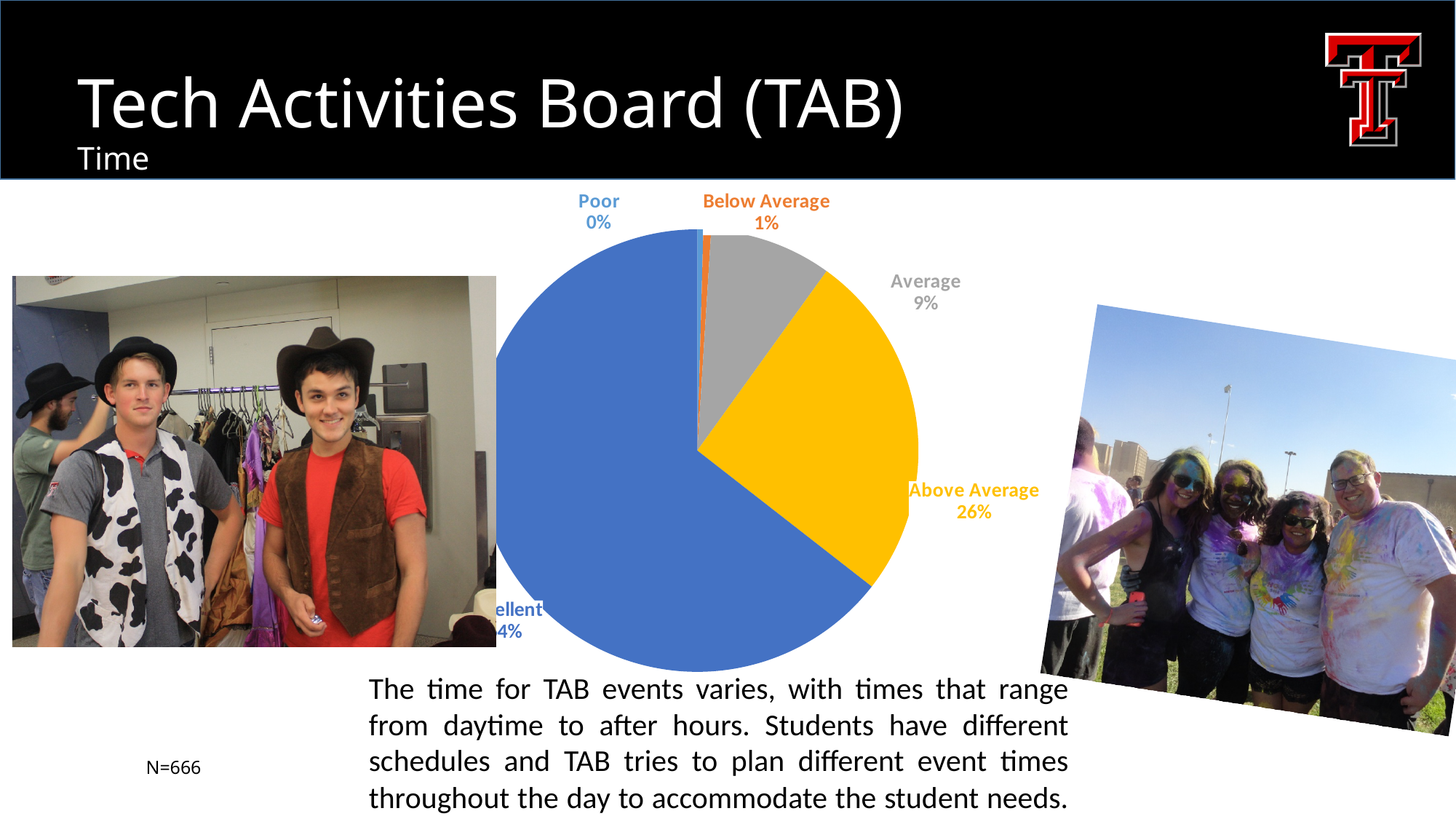
Which is larger, the share for Above Average or the share for Average? Above Average What is the combined share of the Average and Below Average slices? 10% What colour is the Above Average slice of the pie chart? yellow How many slices does the pie chart have? 5 What percentage of respondents rated the time of TAB events as Above Average? 26% What is the difference in percentage points between the Above Average and Average shares? 17% What percentage of respondents rated the time of TAB events as Below Average? 1% What sample size (N) is stated on the slide for the chart? N=666 What percentage of respondents rated the time of TAB events as Average? 9% Which rating category has the smallest share of the pie? Poor What percentage of respondents rated the time of TAB events as Poor? 0% What kind of chart is shown on the slide? pie chart